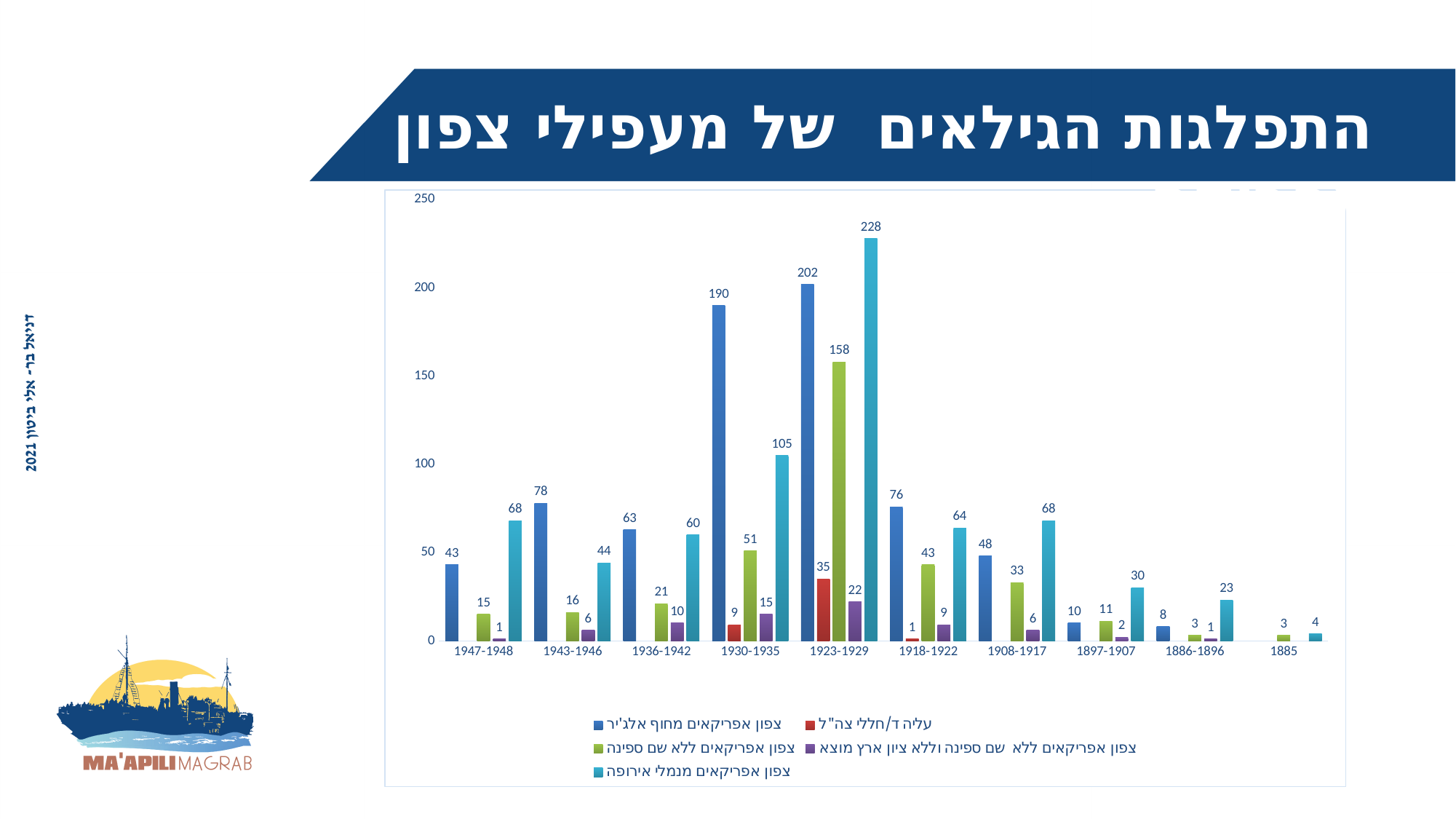
What is the difference between the צפון אפריקאים מחוף אלג'יר value for 1923-1929 and for 1930-1935? 12 Which category has the lowest value for the צפון אפריקאים מנמלי אירופה series? 1885 Is the value of the צפון אפריקאים ללא שם ספינה series for 1923-1929 greater or less than 150? greater How many age-group categories are shown on the x axis? 10 Which is larger for 1936-1942: the צפון אפריקאים מחוף אלג'יר value or the צפון אפריקאים מנמלי אירופה value? צפון אפריקאים מחוף אלג'יר What is the title of the chart? התפלגות הגילאים של מעפילי צפון What type of chart is shown on the slide? bar chart Which category has the highest value for the צפון אפריקאים ללא שם ספינה series? 1923-1929 What is the value of the צפון אפריקאים מחוף אלג'יר series for 1930-1935? 190 What is the value of the צפון אפריקאים מנמלי אירופה series for 1923-1929? 228 How many series does the legend list? 5 What is the value of the עליה ד/חללי צה"ל series for 1923-1929? 35